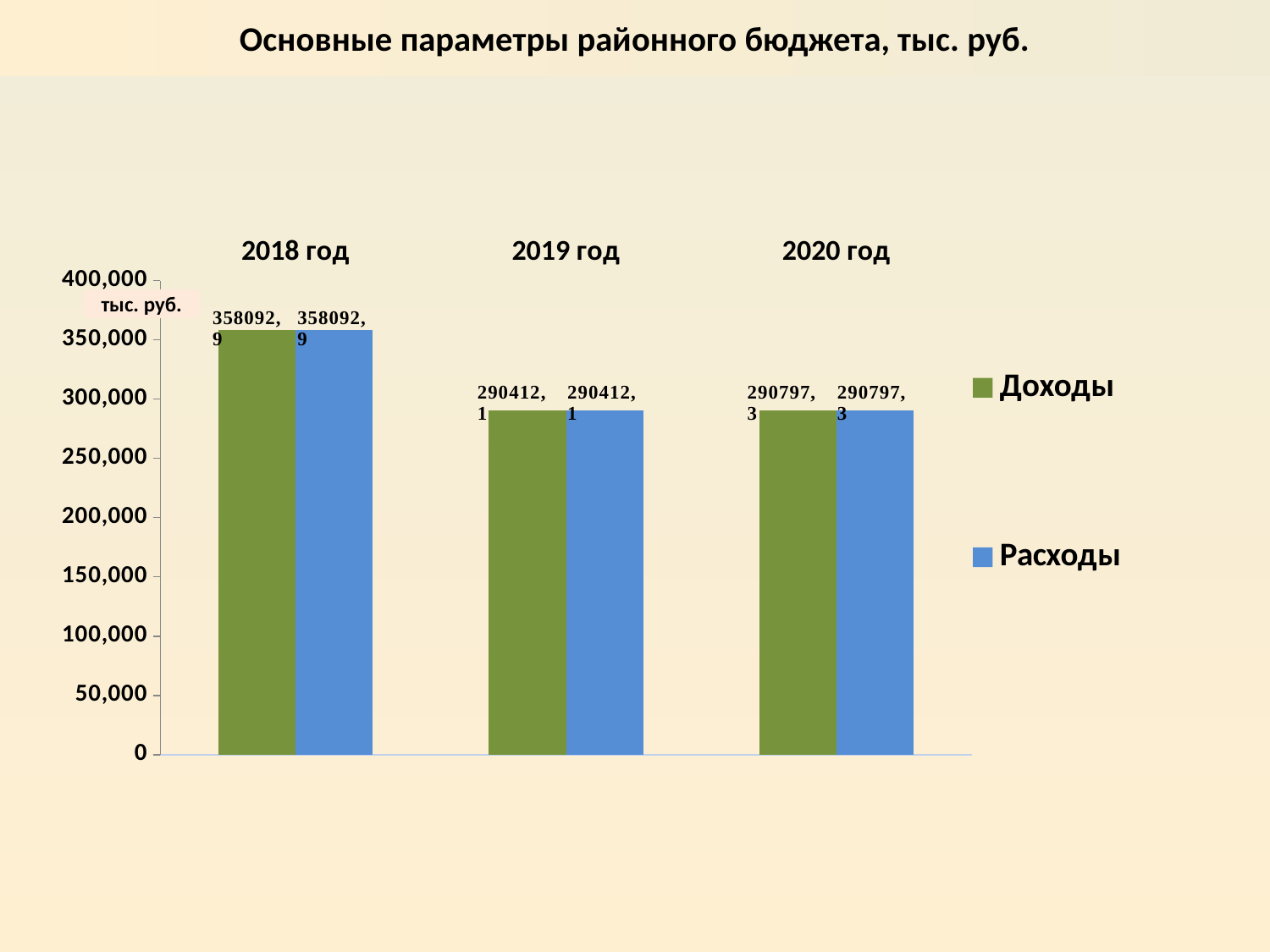
What is the difference between Доходы and Расходы in 2018 год? 0 Which is larger: Расходы in 2018 год or Расходы in 2019 год? Расходы in 2018 год What is the value of Расходы for 2019 год? 290412,1 What kind of chart is shown on the slide? bar chart Is the value of Доходы for 2019 год greater or less than 300,000? less What is the value of Доходы for 2018 год? 358092,9 How many years are shown on the x axis? 3 Is the value of Расходы for 2018 год greater or less than 350,000? greater What is the difference between Доходы in 2018 год and Доходы in 2019 год? 67680,8 Which year has the highest value of Доходы? 2018 год What is the value of Доходы for 2020 год? 290797,3 How many series does the legend list? 2